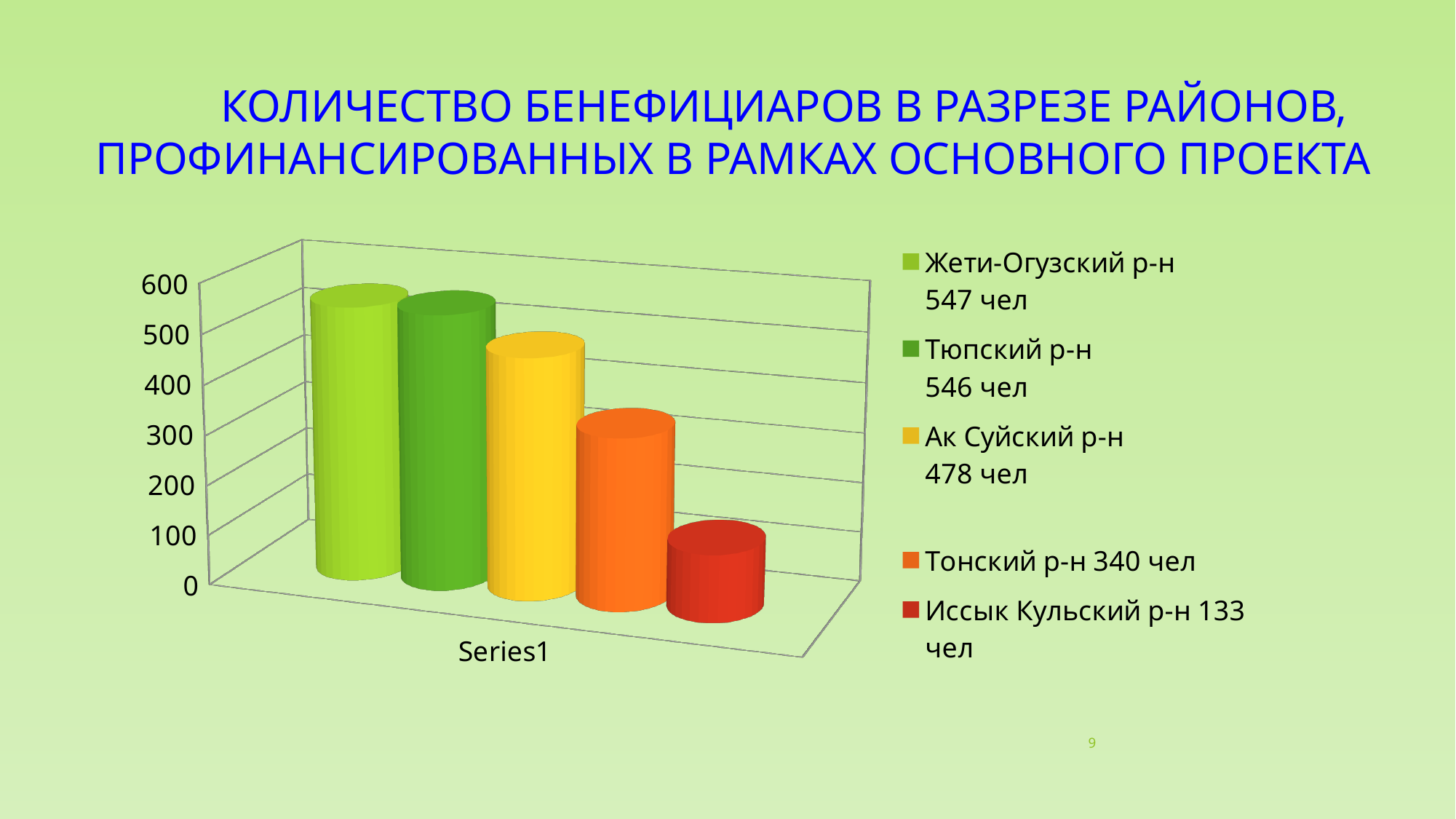
What is the value for Иссык Кульский р-н? 133 чел What is the difference between the values for Тонский р-н and Иссык Кульский р-н? 207 чел How many bars are shown in the chart? 5 What is the difference between the values for Ак Суйский р-н and Тонский р-н? 138 чел What kind of chart is shown on the slide? bar chart How many entries does the legend list? 5 What is the value for Ак Суйский р-н? 478 чел Which is larger, the value for Ак Суйский р-н or the value for Тонский р-н? Ак Суйский р-н Which district has the lowest number of beneficiaries? Иссык Кульский р-н Is the value for Иссык Кульский р-н greater or less than 200? less Do the bar values rise or fall from left to right? fall What is the value for Жети-Огузский р-н? 547 чел